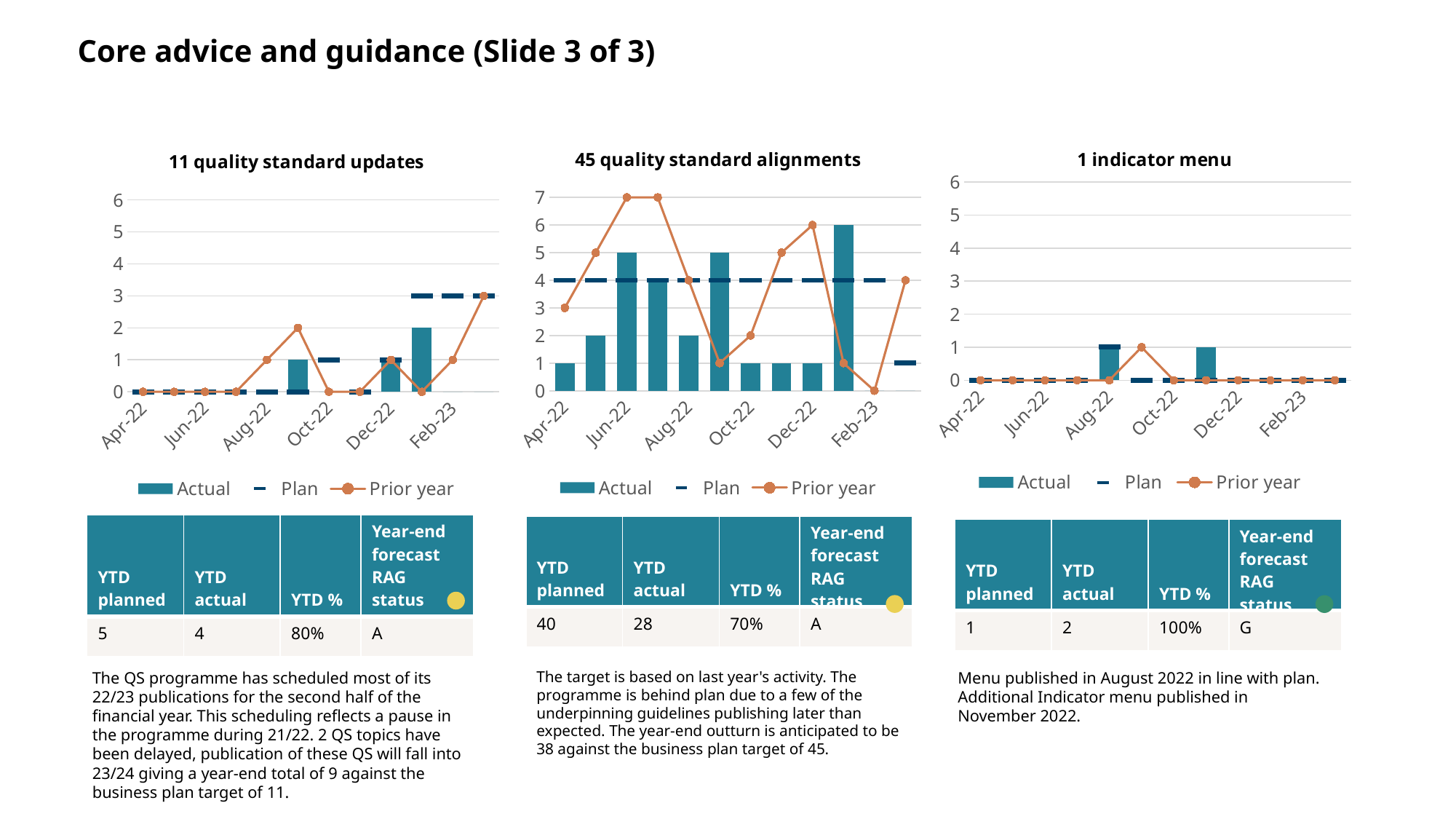
In the '11 quality standard updates' chart, what is the Prior year value for Feb-23? 1 How many series does the legend list for the '11 quality standard updates' chart? 3 In the '45 quality standard alignments' chart, which is larger for Aug-22: the Actual value or the Prior year value? Prior year In the '45 quality standard alignments' chart, what is the Actual value for Jun-22? 5 In the '1 indicator menu' chart, what is the Actual value for Dec-22? 0 In the '45 quality standard alignments' chart, what is the Prior year value for Jun-22? 7 In the '45 quality standard alignments' chart, what is the difference between the Prior year value for Jun-22 and the Actual value for Jun-22? 2 What type of chart is the '45 quality standard alignments' chart? Combined bar and line chart In the '1 indicator menu' chart, what is the Actual value for Aug-22? 1 In the '11 quality standard updates' chart, what is the Plan value for Feb-23? 3 In the '45 quality standard alignments' chart, what is the Prior year value for Dec-22? 6 In the '45 quality standard alignments' chart, is the Actual value for Feb-23 greater or less than 1? less